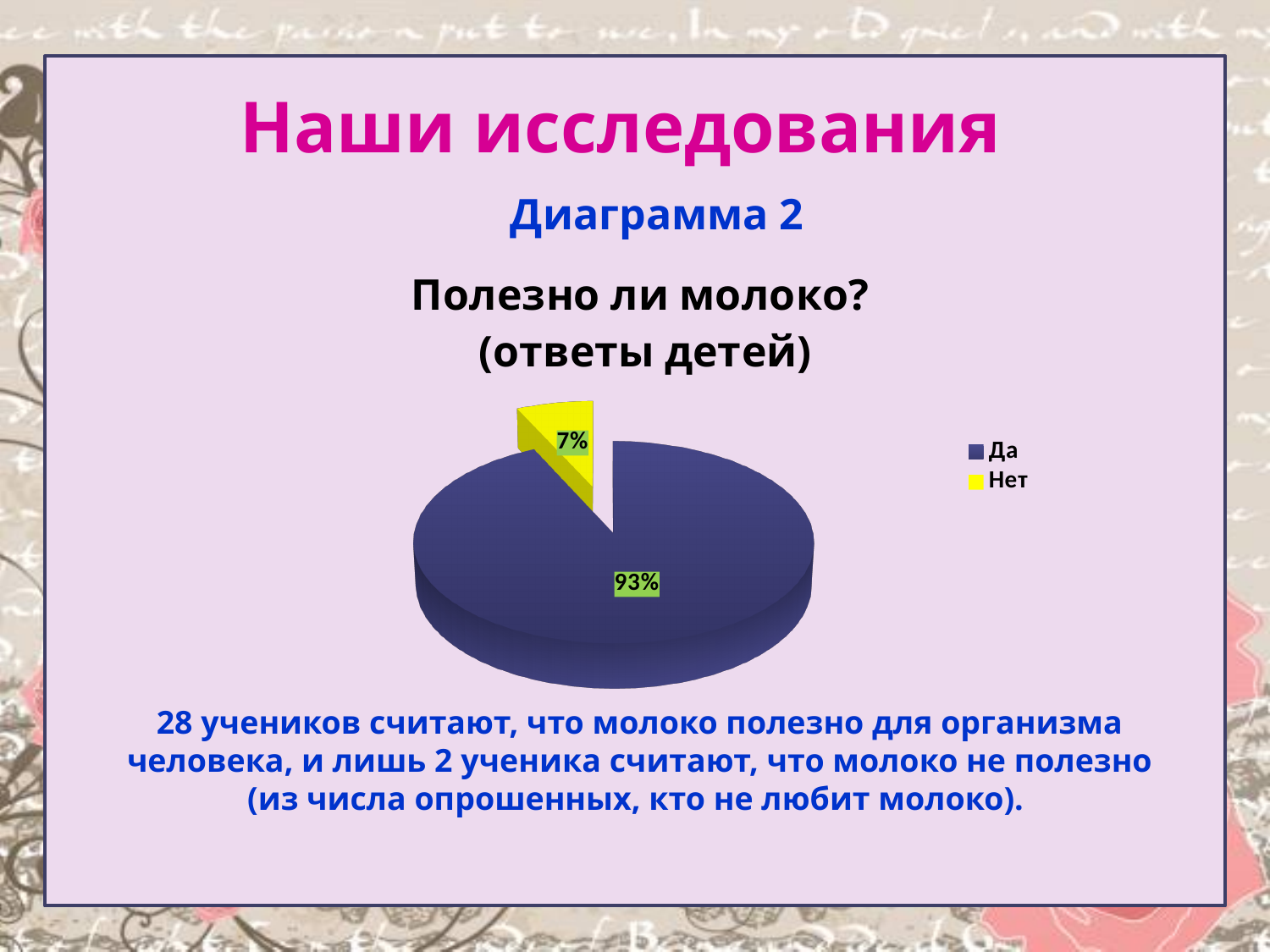
How many slices does the pie chart have? 2 Which slice of the pie is the smallest? Нет What percentage of the pie is labelled "Нет"? 7% Is the share of the "Да" slice greater or less than 50%? greater What percentage of the pie is labelled "Да"? 93% What is the difference in percentage points between the "Да" and "Нет" slices? 86 What colour is the "Нет" slice in the pie chart? yellow Which slice is larger, "Да" or "Нет"? Да Which slice of the pie is the largest? Да What is the title of the chart? Полезно ли молоко? (ответы детей) What type of chart is shown on the slide? pie chart How many entries does the legend list? 2